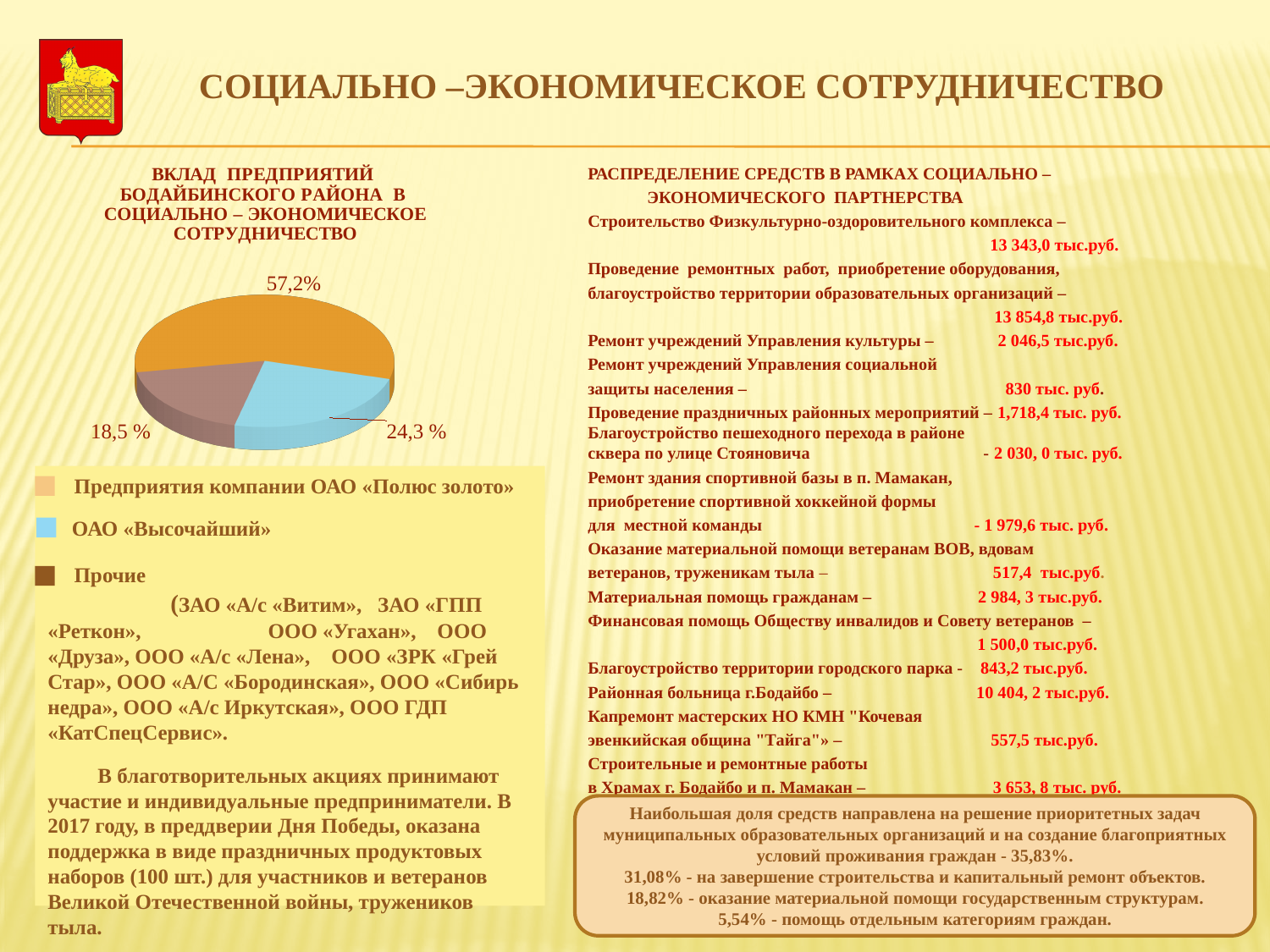
What share of the pie chart corresponds to «Прочие»? 18,5 % What share of the pie chart corresponds to «Предприятия компании ОАО «Полюс золото»»? 57,2% What is the title of the pie chart on the left of the slide? ВКЛАД ПРЕДПРИЯТИЙ БОДАЙБИНСКОГО РАЙОНА В СОЦИАЛЬНО – ЭКОНОМИЧЕСКОЕ СОТРУДНИЧЕСТВО Which category has the smallest slice in the pie chart? Прочие What is the difference in percentage points between the slice for ОАО «Полюс золото» and the slice for ОАО «Высочайший»? 32,9 How many slices does the pie chart have? 3 Which category has the largest slice in the pie chart? Предприятия компании ОАО «Полюс золото» What kind of chart is shown on the slide? pie chart Which slice is larger: ОАО «Высочайший» or «Прочие»? ОАО «Высочайший» How many entries does the legend of the pie chart list? 3 What colour is the slice for ОАО «Высочайший» in the pie chart? light blue What share of the pie chart corresponds to ОАО «Высочайший»? 24,3 %